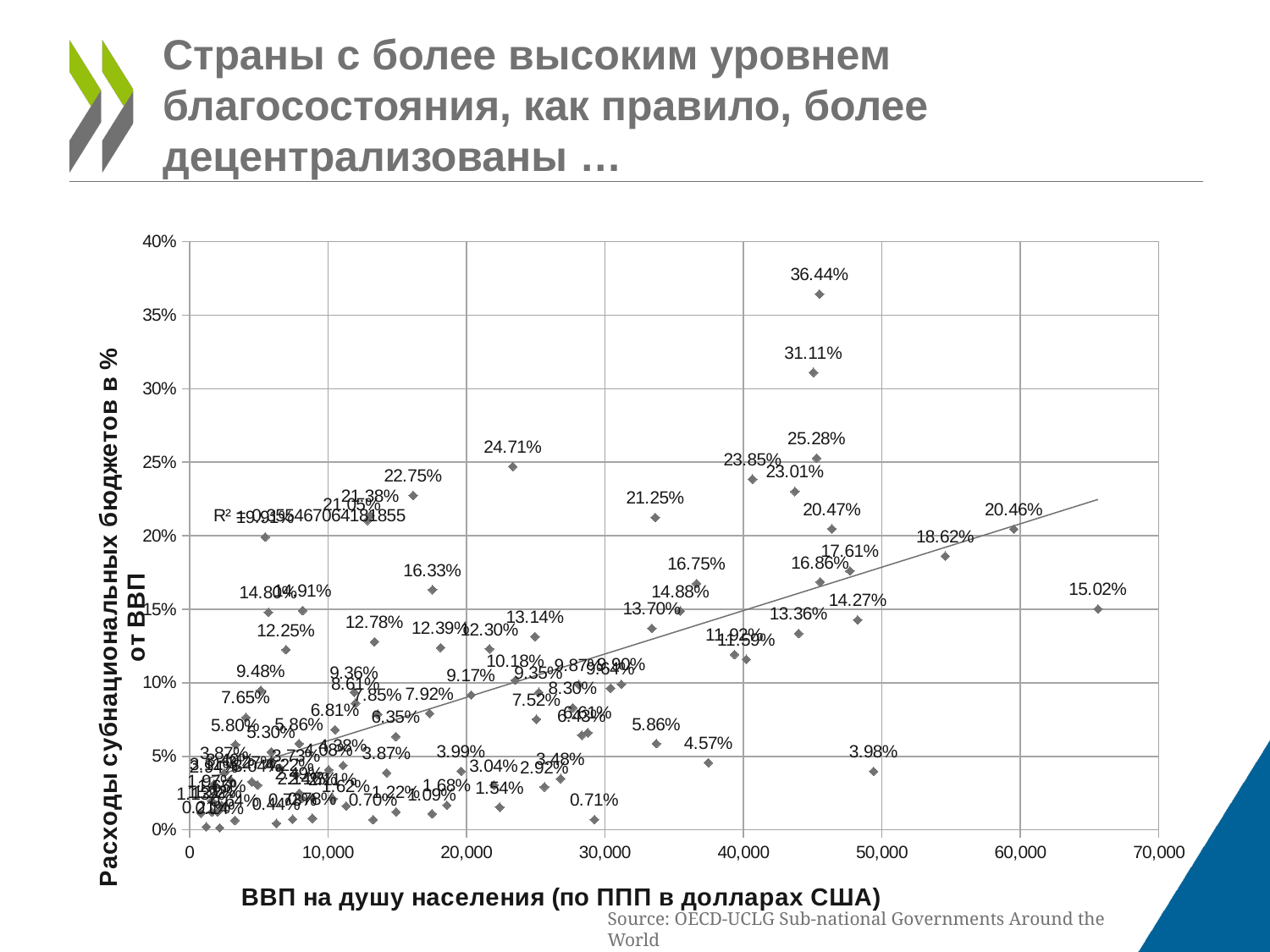
What is the difference between the two highest labelled values on the chart (36.44% and 31.11%)? 5.33% What is the maximum value shown on the y axis? 40% According to the trend line, do subnational budget expenditures generally rise or fall as GDP per capita increases? rise What is the second-highest data label value shown on the chart? 31.11% Is the y value of the point labelled 24.71% greater or less than 20%? greater Is the GDP per capita (x value) of the point labelled 36.44% greater or less than 40,000? greater What kind of chart is shown on the slide? scatter plot What is the highest data label value shown on the chart? 36.44% Which is larger: the point labelled 24.71% or the point labelled 22.75%? 24.71% What is the data label of the rightmost point on the chart (near 65,000 on the x axis)? 15.02% What is the title of the x axis? ВВП на душу населения (по ППП в долларах США)